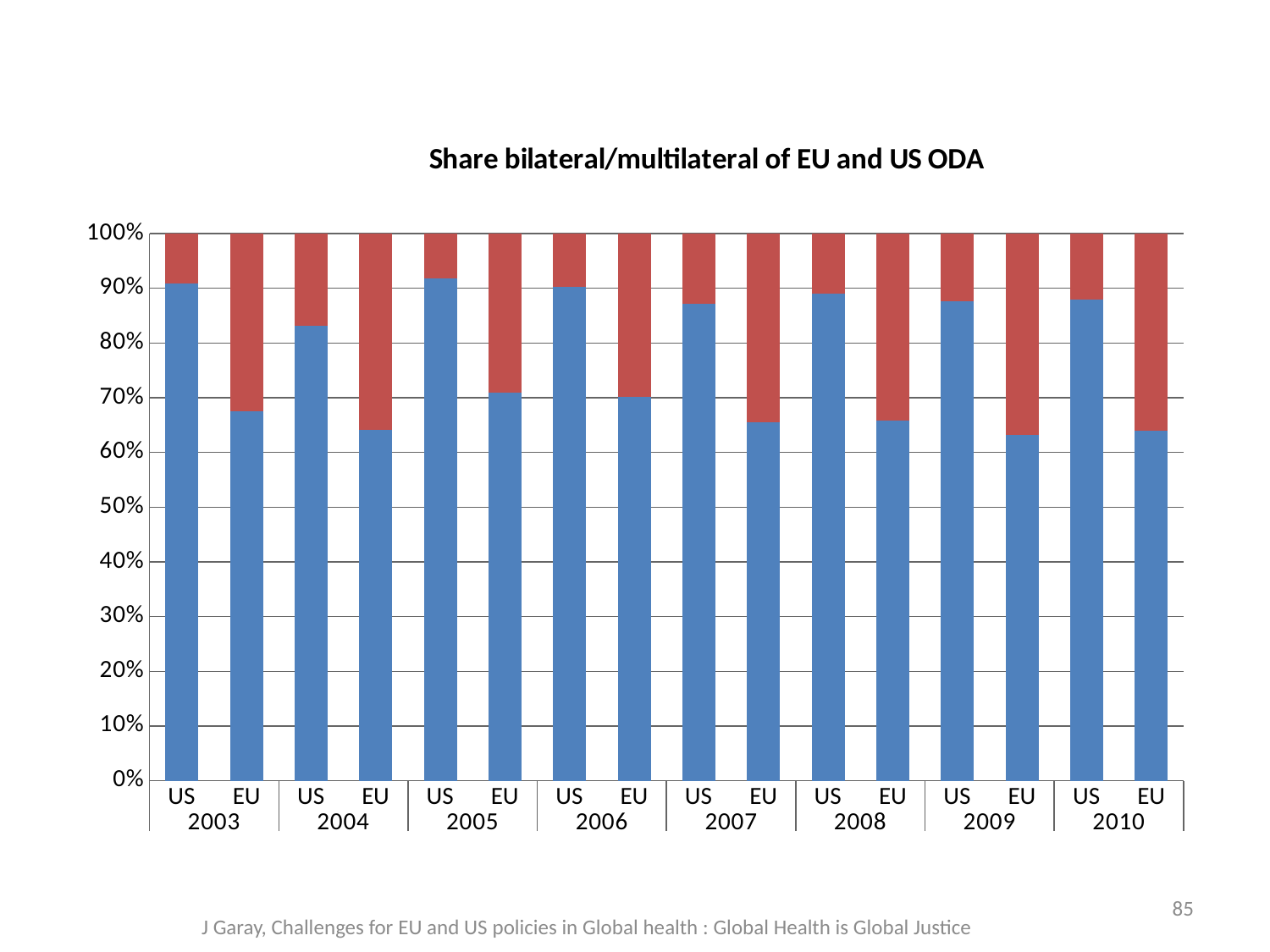
Is the blue portion of the EU bar for 2007 greater or less than 70%? less Which has the larger blue portion, the US bar for 2004 or the US bar for 2005? US 2005 What is the title of the chart? Share bilateral/multilateral of EU and US ODA What is the total height of each stacked bar in the chart? 100% How many bars are plotted in the chart? 16 Is the blue portion of the EU bar for 2009 greater or less than 60%? greater What kind of chart is shown on the slide? stacked bar chart How many years are shown along the x axis of the chart? 8 Which two colours are used for the stacked segments in the chart? blue and red In 2003, which has the larger blue portion, the US bar or the EU bar? US Is the blue portion of the US bar for 2004 greater or less than 90%? less